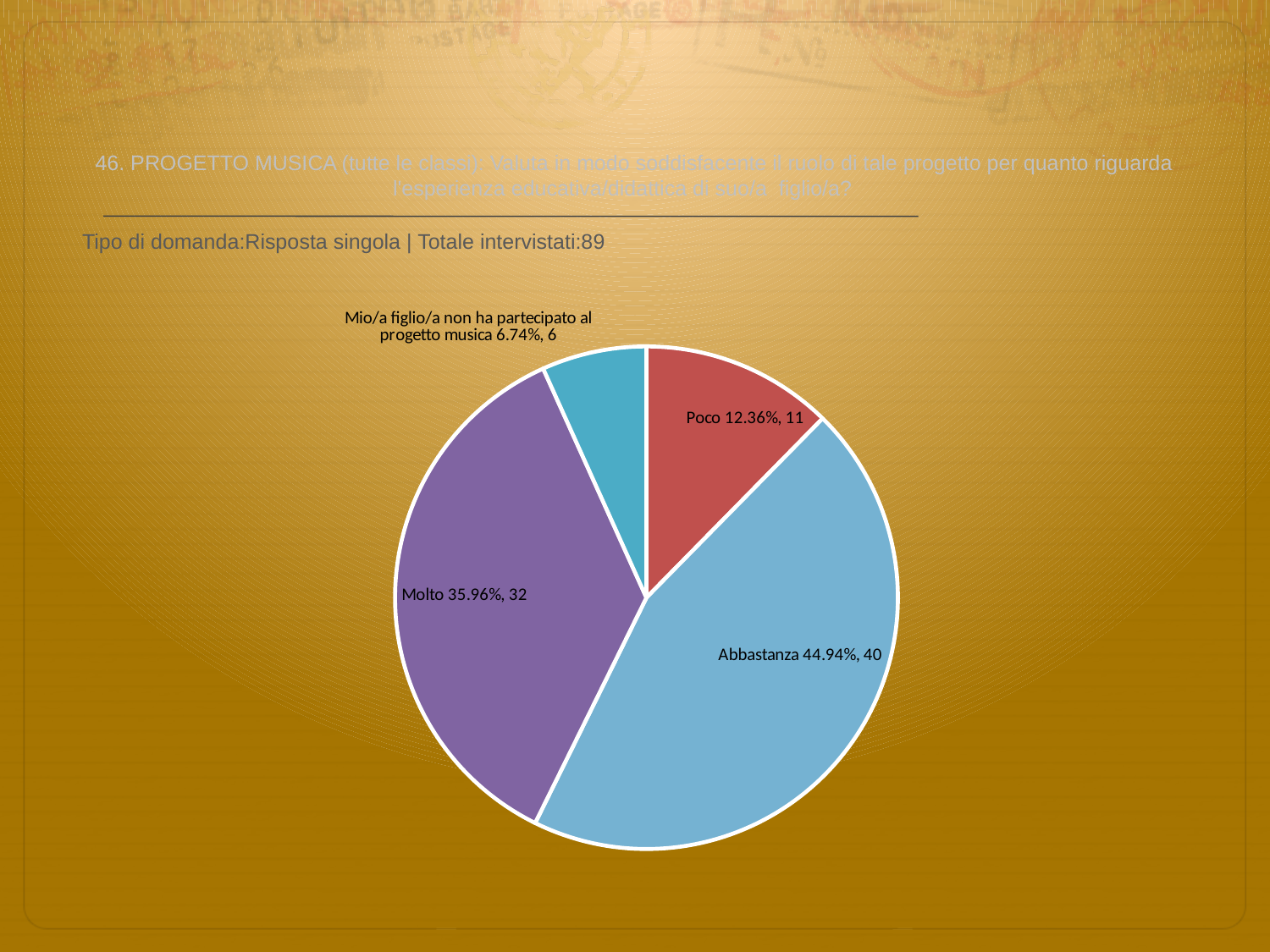
What kind of chart is shown on the slide? pie chart What colour is the 'Molto' slice? purple What is the total number of respondents (Totale intervistati) stated on the slide? 89 Which has more respondents, 'Poco' or 'Mio/a figlio/a non ha partecipato al progetto musica'? Poco What percentage share does the 'Abbastanza' slice have? 44.94% What percentage share does the 'Mio/a figlio/a non ha partecipato al progetto musica' slice have? 6.74% How many slices does the pie chart have? 4 What is the difference in respondent count between 'Abbastanza' and 'Molto'? 8 Which category has the largest slice? Abbastanza How many respondents answered 'Molto'? 32 Which category has the smallest slice? Mio/a figlio/a non ha partecipato al progetto musica How many respondents answered 'Poco'? 11